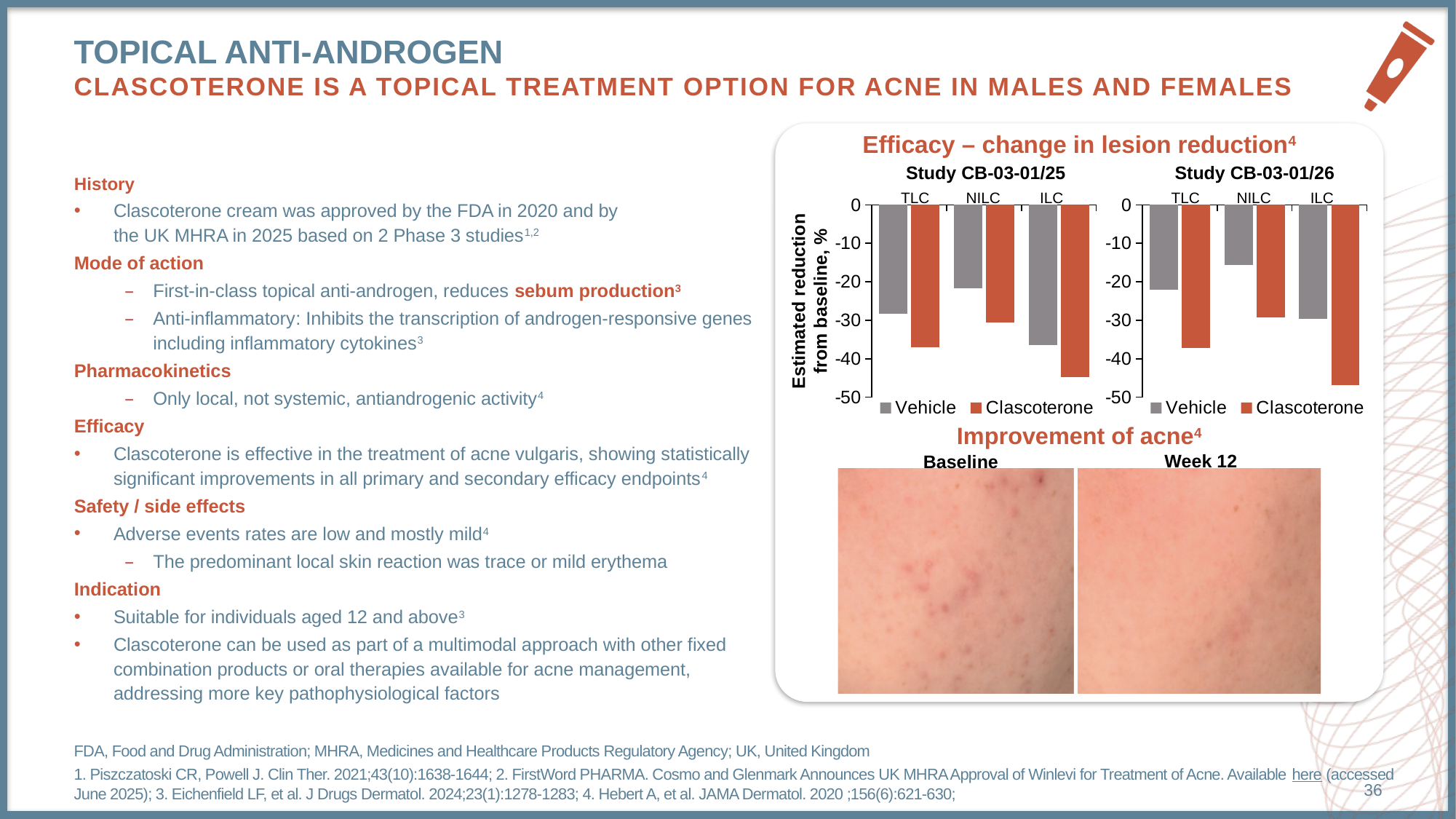
In the Study CB-03-01/26 chart, is the Clascoterone value for ILC greater or less than -40? less In the Study CB-03-01/26 chart, which series shows the larger reduction for TLC, Vehicle or Clascoterone? Clascoterone What is the y-axis label of the Study CB-03-01/25 chart? Estimated reduction from baseline, % In the Study CB-03-01/25 chart, how many categories are shown on the x axis? 3 In the Study CB-03-01/26 chart, is the Vehicle value for NILC greater or less than -20? greater In the Study CB-03-01/25 chart, for which category does Clascoterone show the largest reduction from baseline? ILC In the Study CB-03-01/25 chart, which series is shown in orange? Clascoterone In the Study CB-03-01/26 chart, for which category does Vehicle show the smallest reduction from baseline? NILC What kind of chart is used for Study CB-03-01/25? bar chart In the Study CB-03-01/25 chart, is the Vehicle value for NILC greater or less than -30? greater In the Study CB-03-01/26 chart, how many series does the legend list? 2